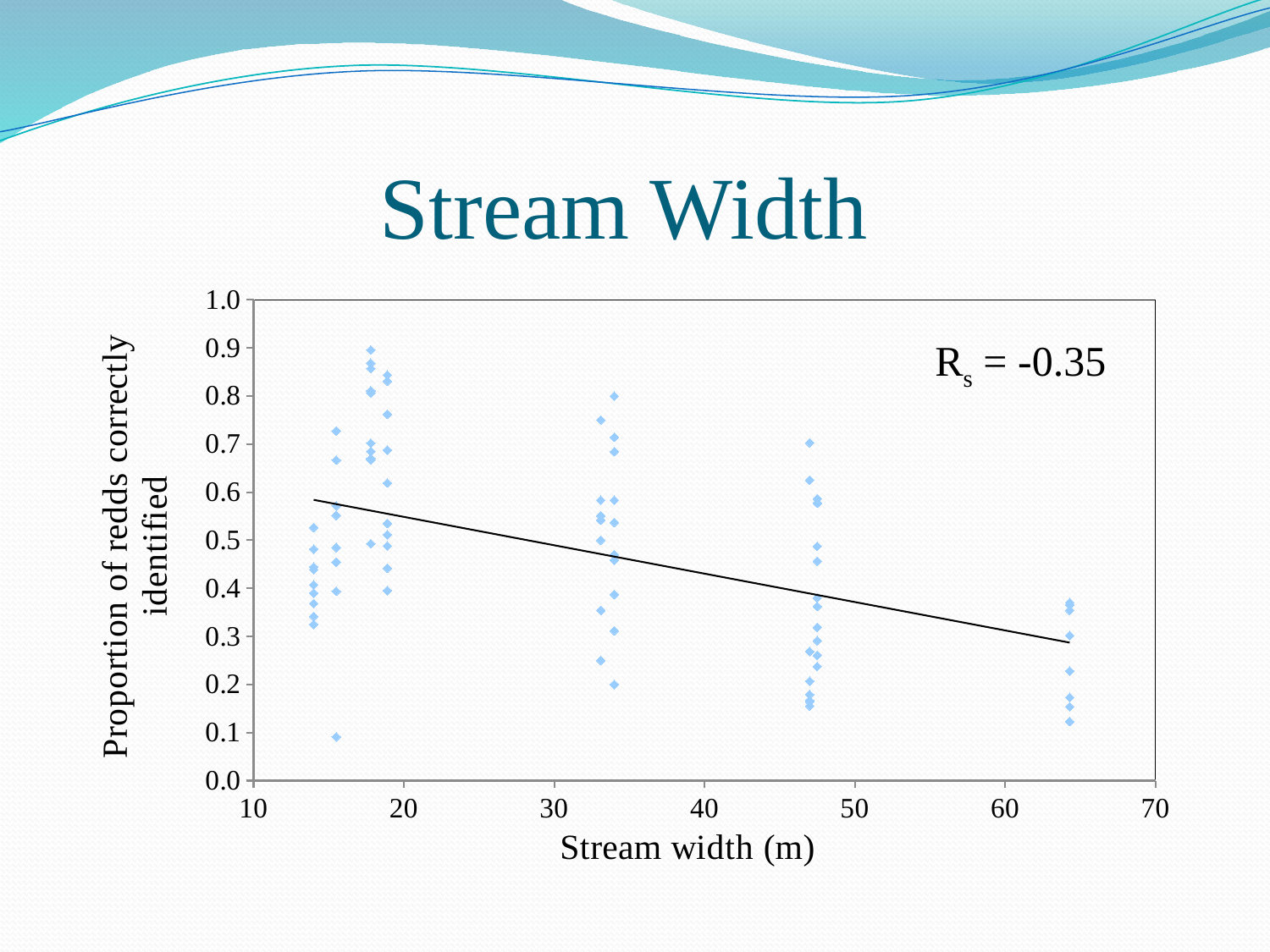
What is the maximum value shown on the x axis? 70 Is the highest plotted point near a stream width of 64 m greater or less than 0.5? less Which cluster of points reaches a higher maximum proportion: the one near 18 m or the one near 64 m? 18 m Is the highest plotted point near a stream width of 47 m greater or less than 0.6? greater What value of Rs is printed on the chart? -0.35 Is the lowest plotted point on the chart (near a stream width of 15 m) greater or less than 0.2? less What is the title of the chart? Stream Width What kind of chart is shown on the slide? Scatter plot What is the label of the x axis? Stream width (m) Does the fitted trend line rise or fall as stream width increases? Falls